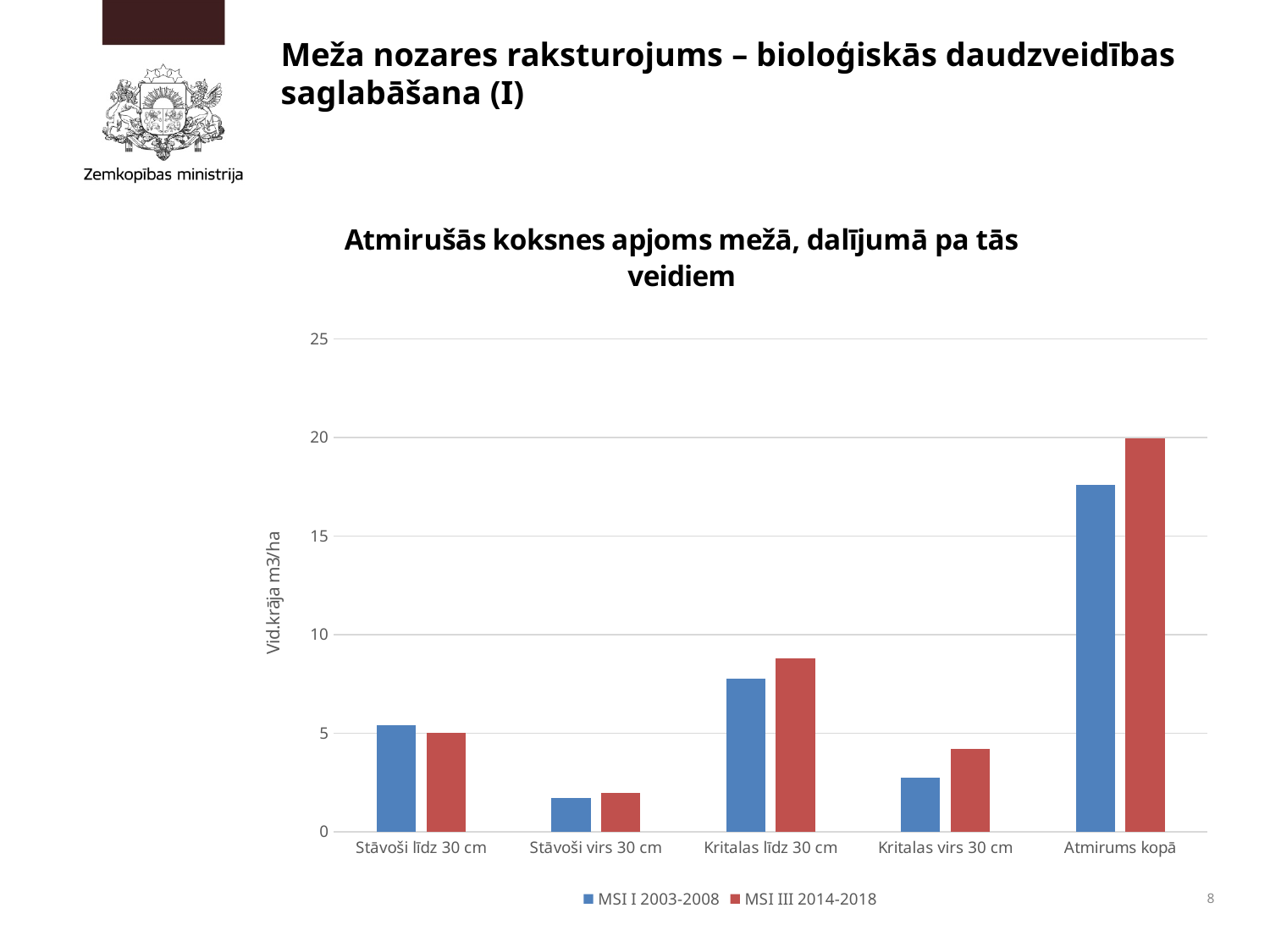
What is the title of the chart? Atmirušās koksnes apjoms mežā, dalījumā pa tās veidiem For the MSI I 2003-2008 series, which is larger: Kritalas līdz 30 cm or Stāvoši līdz 30 cm? Kritalas līdz 30 cm Is the MSI I 2003-2008 value for Atmirums kopā greater or less than 15? greater Which category has the highest value for the MSI III 2014-2018 series? Atmirums kopā Is the MSI I 2003-2008 value for Kritalas līdz 30 cm greater or less than 10? less How many categories are shown on the x axis of the chart? 5 Is the MSI III 2014-2018 value for Kritalas virs 30 cm greater or less than 5? less How many series does the chart's legend list? 2 What kind of chart is shown on the slide? bar chart What is the label of the vertical axis? Vid.krāja m3/ha For Kritalas virs 30 cm, which series has the larger value, MSI I 2003-2008 or MSI III 2014-2018? MSI III 2014-2018 Which category has the lowest value for the MSI I 2003-2008 series? Stāvoši virs 30 cm